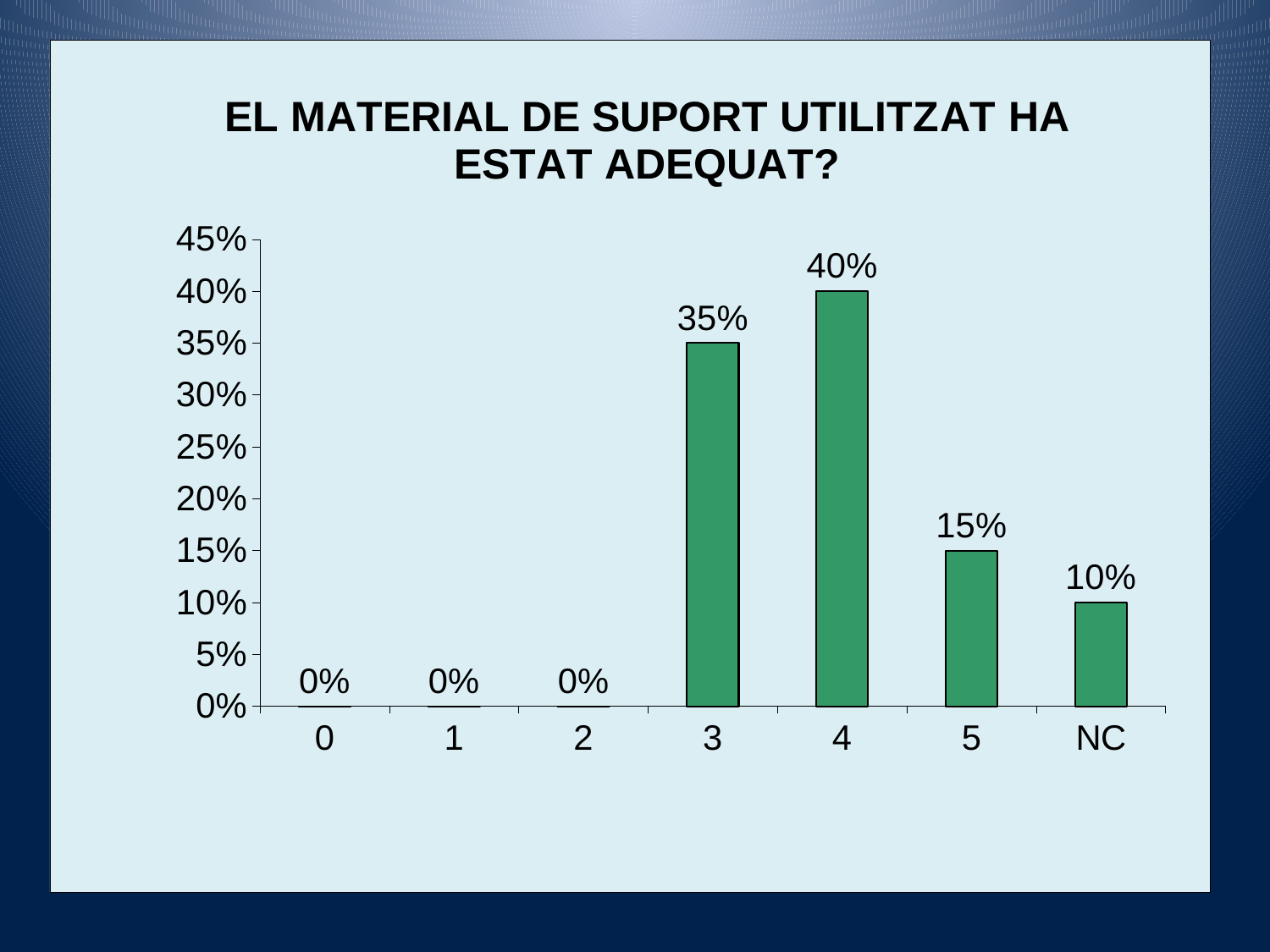
What is the value for category 4? 40% How many categories have a value of 0%? 3 How many categories are shown on the x axis? 7 Which category has the highest value? 4 What is the difference between the values for category 4 and category 3? 5% Which is larger, the value for category 3 or the value for category 5? 3 What is the difference between the values for category 5 and NC? 5% What is the value for category 5? 15% What is the value for category 3? 35% What kind of chart is shown? bar chart What is the value for NC? 10% What is the title of the chart? EL MATERIAL DE SUPORT UTILITZAT HA ESTAT ADEQUAT?